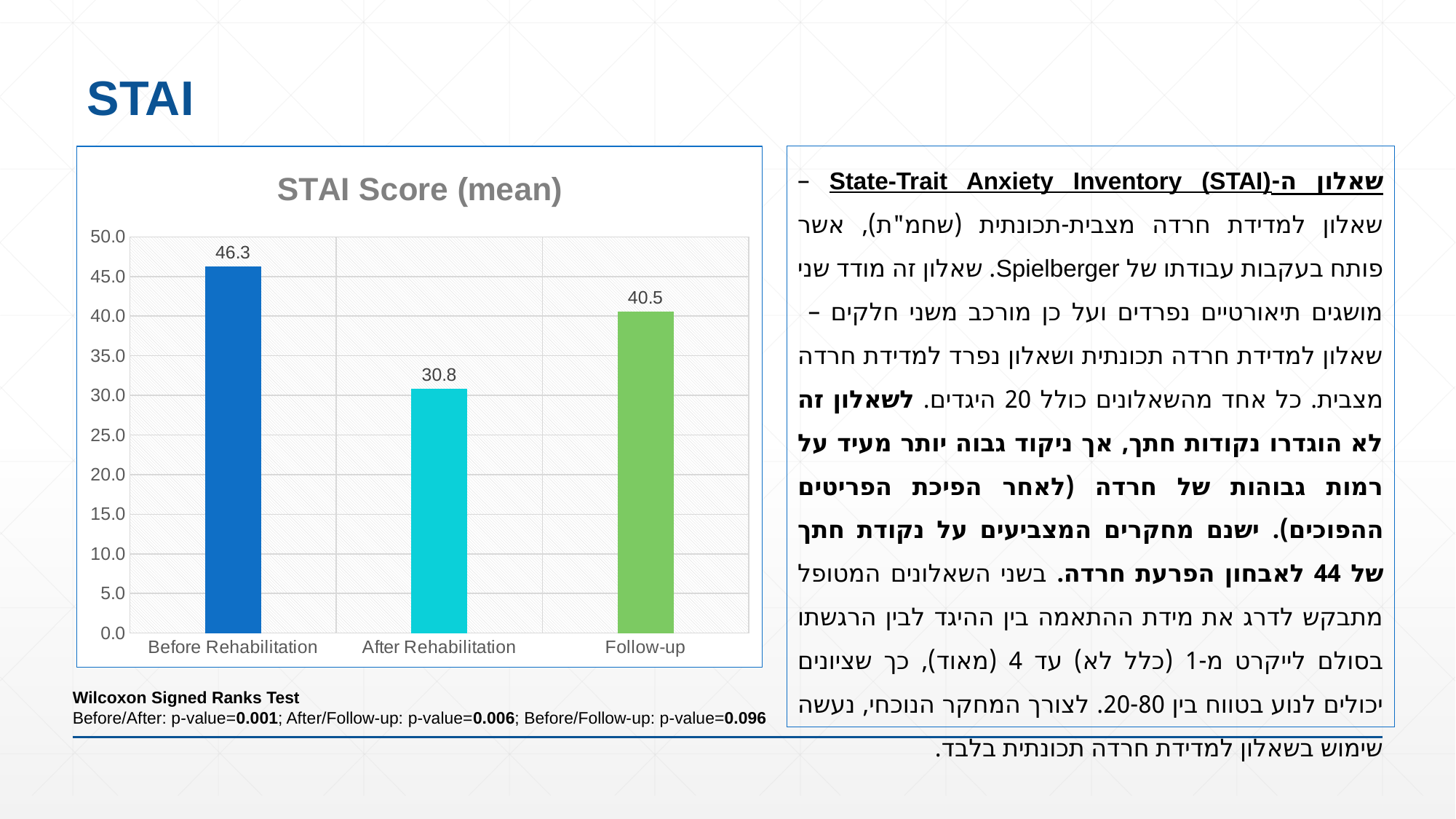
What is the difference between the Follow-up and After Rehabilitation mean STAI scores? 9.7 What kind of chart is shown on the slide? bar chart Which category has the lowest mean STAI score? After Rehabilitation What is the mean STAI score for After Rehabilitation? 30.8 Is the mean STAI score for After Rehabilitation greater or less than 35.0? less What is the difference between the Before Rehabilitation and After Rehabilitation mean STAI scores? 15.5 What is the mean STAI score for Before Rehabilitation? 46.3 Which is larger, the mean STAI score at Follow-up or Before Rehabilitation? Before Rehabilitation Which category has the highest mean STAI score? Before Rehabilitation What is the mean STAI score at Follow-up? 40.5 How many categories are shown on the x axis of the chart? 3 What is the title of the chart? STAI Score (mean)